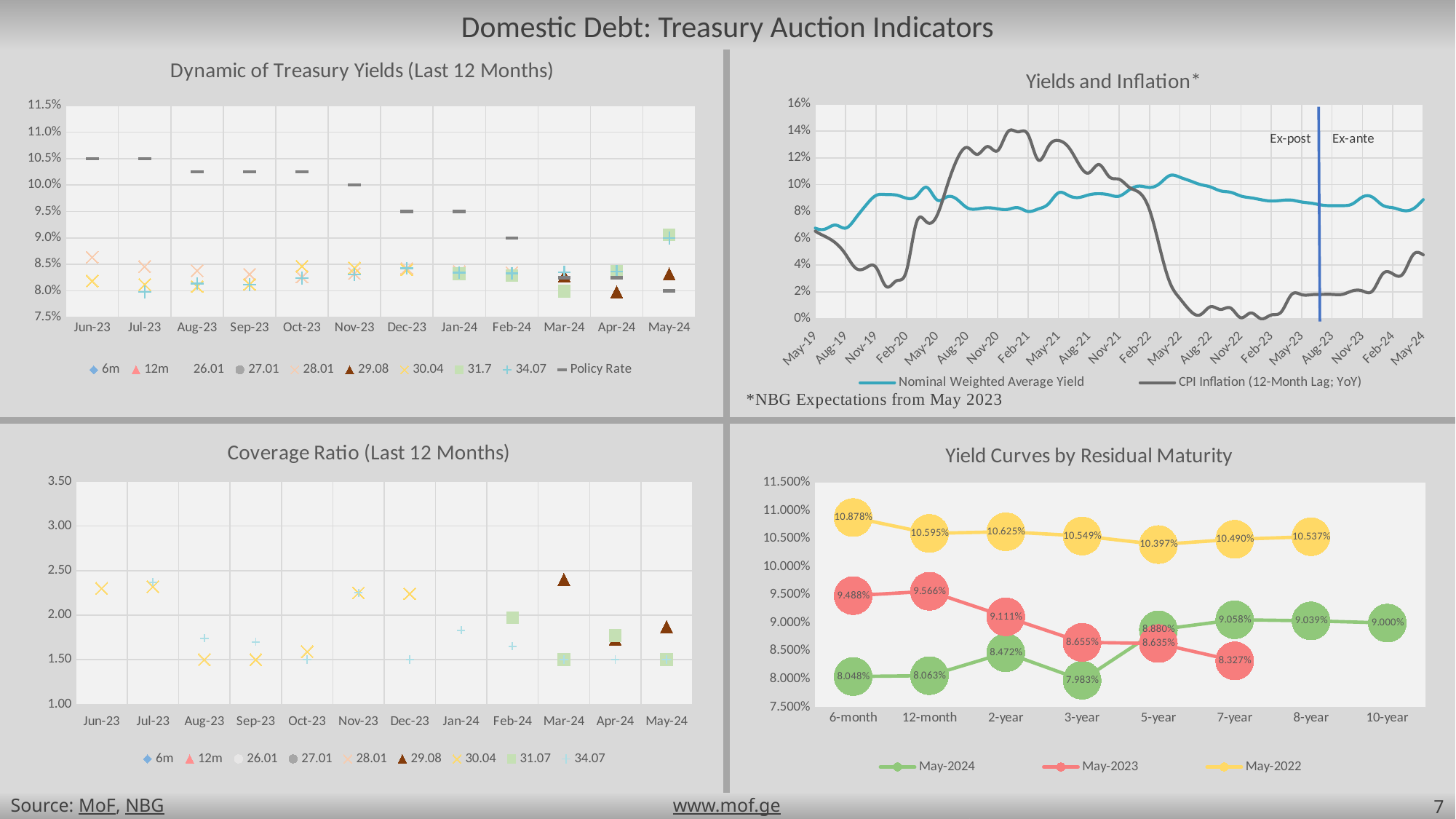
In the Yield Curves by Residual Maturity chart, what is the May-2024 yield for the 10-year maturity? 9.000% In the Yield Curves by Residual Maturity chart, which maturity has the lowest May-2024 yield? 3-year How many maturity categories are shown on the x axis of the Yield Curves by Residual Maturity chart? 8 In the Yields and Inflation chart, is the CPI Inflation value at Feb-21 greater or less than 12%? greater In the Dynamic of Treasury Yields chart, what is the Policy Rate in Jun-23? 10.5% How many series does the legend of the Yield Curves by Residual Maturity chart list? 3 In the Yield Curves by Residual Maturity chart, which maturity has the highest May-2022 yield? 6-month What kind of chart is the Yields and Inflation chart? line chart In the Yield Curves by Residual Maturity chart, what is the May-2022 yield for the 6-month maturity? 10.878% In the Yield Curves by Residual Maturity chart, how much higher is the May-2023 6-month yield than the May-2024 6-month yield? 1.440% In the Yield Curves by Residual Maturity chart, does the May-2023 series generally rise or fall from the 12-month to the 7-year maturity? fall In the Yield Curves by Residual Maturity chart, which is larger for May-2023: the 6-month yield or the 12-month yield? 12-month